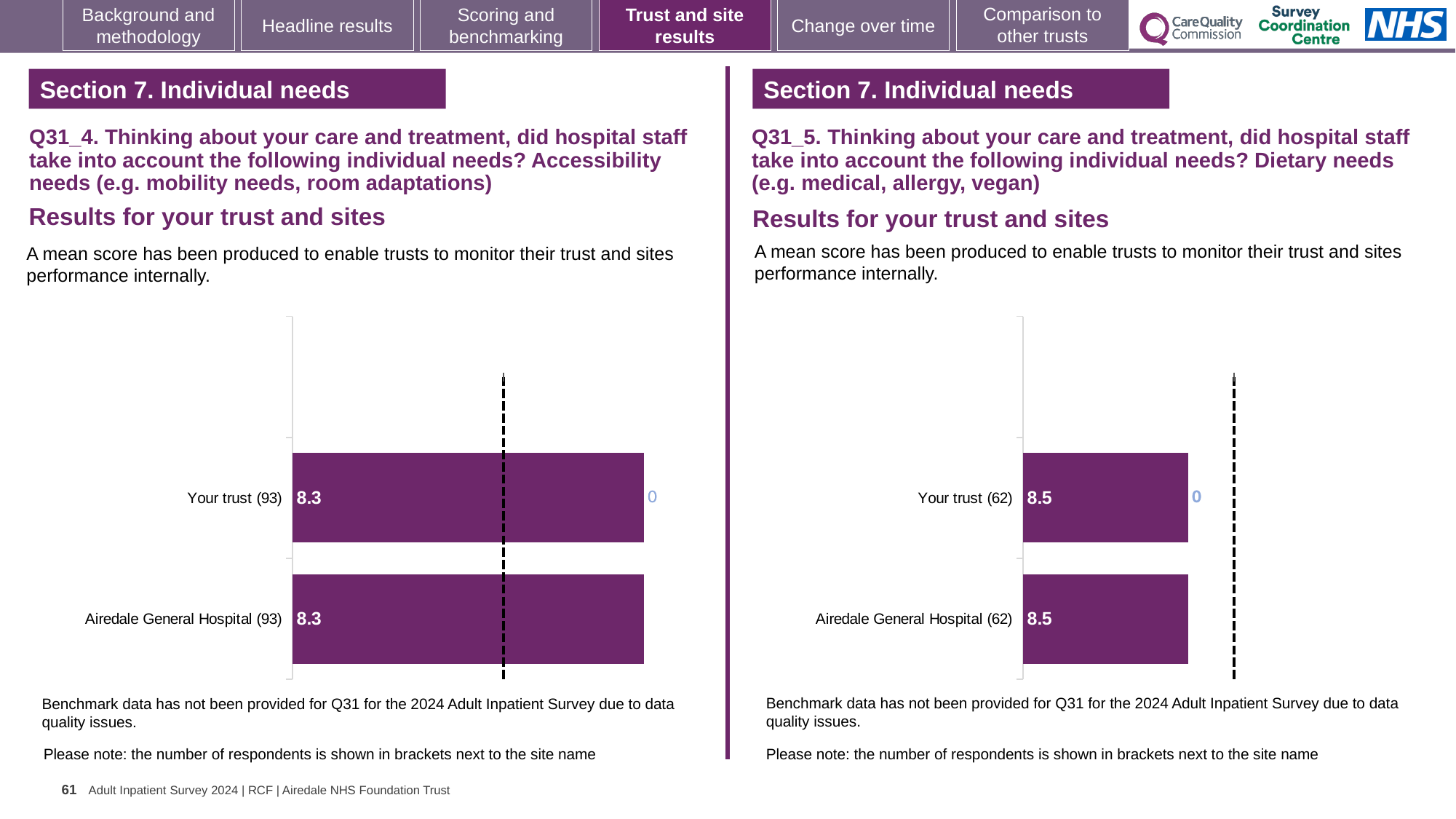
In the left chart (Q31_4, Accessibility needs), what is the difference between the scores for Your trust and Airedale General Hospital? 0 In the left chart (Q31_4, Accessibility needs), how many respondents are shown in brackets next to Your trust? 93 How many bars are plotted in the left chart (Q31_4, Accessibility needs)? 2 In the right chart (Q31_5, Dietary needs), what is the mean score for Your trust? 8.5 In the left chart (Q31_4, Accessibility needs), what is the mean score for Airedale General Hospital? 8.3 In the right chart (Q31_5, Dietary needs), what is the difference between the scores for Your trust and Airedale General Hospital? 0 What type of chart is used in the left chart (Q31_4, Accessibility needs)? Bar chart Which is larger: the Your trust score in the left chart (Q31_4) or the Your trust score in the right chart (Q31_5)? The right chart (Q31_5), 8.5 In the left chart (Q31_4, Accessibility needs), what is the mean score for Your trust? 8.3 In the right chart (Q31_5, Dietary needs), what is the mean score for Airedale General Hospital? 8.5 How many bars are plotted in the right chart (Q31_5, Dietary needs)? 2 In the right chart (Q31_5, Dietary needs), how many respondents are shown in brackets next to Airedale General Hospital? 62